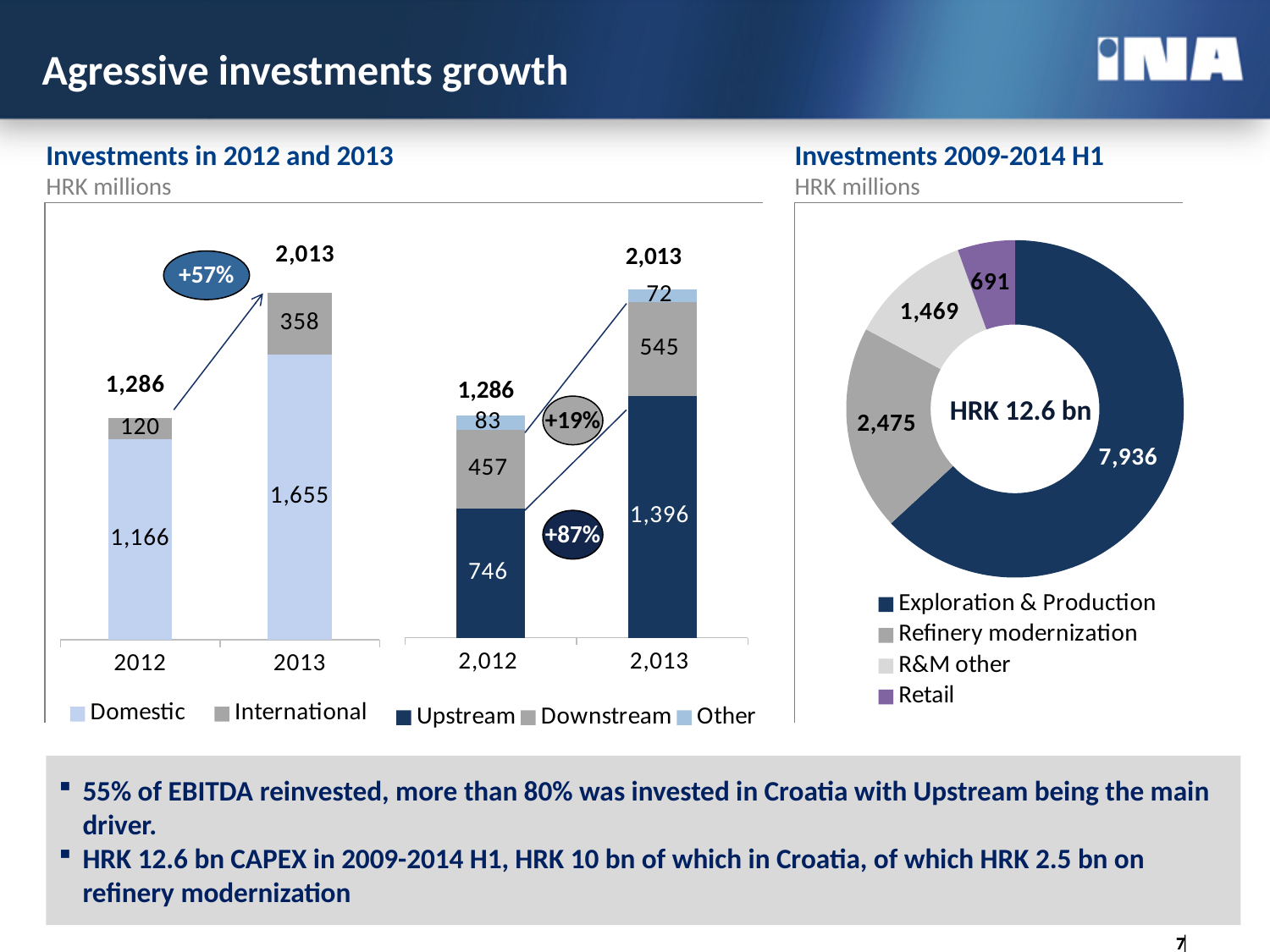
What total is shown in the centre of the 'Investments 2009-2014 H1' chart? HRK 12.6 bn In the 'Investments in 2012 and 2013' Domestic/International chart, by how much did International investment increase from 2012 to 2013? 238 What kind of chart is the 'Investments 2009-2014 H1' chart? doughnut (pie) chart How many series does the legend of the Upstream/Downstream/Other chart list? 3 In the 'Investments 2009-2014 H1' chart, what is the value for Refinery modernization? 2,475 In the Upstream/Downstream/Other chart, what is the Upstream value for 2013? 1,396 In the 'Investments 2009-2014 H1' chart, which category has the largest value? Exploration & Production In the 'Investments in 2012 and 2013' Domestic/International chart, what is the Domestic value for 2013? 1,655 In the 'Investments in 2012 and 2013' Domestic/International chart, what is the total of the 2013 stacked bar? 2,013 In the Upstream/Downstream/Other chart, what is the difference between the Upstream values for 2013 and 2012? 650 In the Upstream/Downstream/Other chart, which year has the larger Other value, 2012 or 2013? 2012 In the 'Investments in 2012 and 2013' Domestic/International chart, what is the International value for 2012? 120